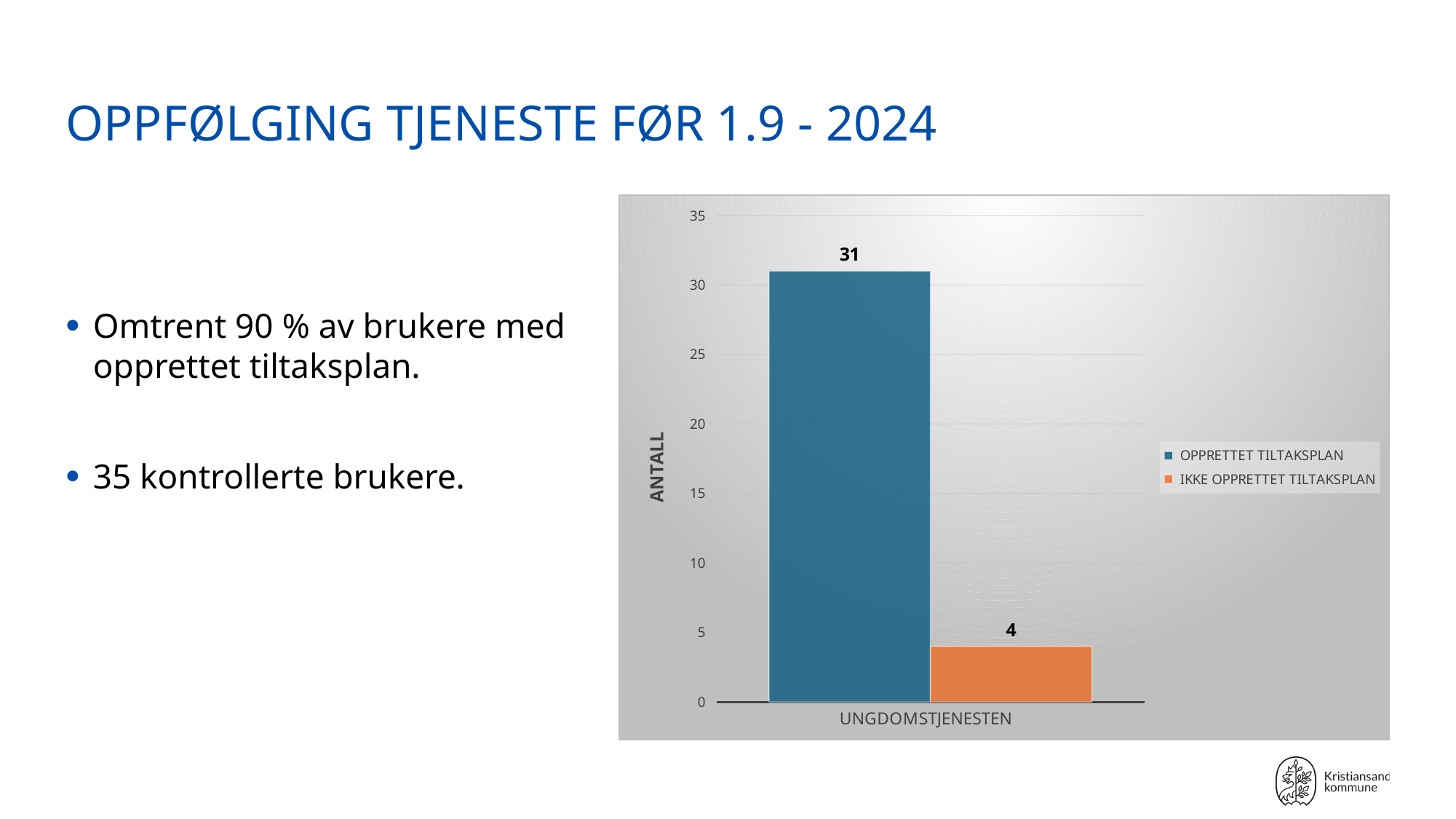
What kind of chart is shown on the slide? bar chart Is the value for OPPRETTET TILTAKSPLAN larger or smaller than the value for IKKE OPPRETTET TILTAKSPLAN? larger What is the label of the vertical axis of the chart? ANTALL Is the value for IKKE OPPRETTET TILTAKSPLAN greater or less than 5? less What is the difference between the values for OPPRETTET TILTAKSPLAN and IKKE OPPRETTET TILTAKSPLAN? 27 Is the value for OPPRETTET TILTAKSPLAN greater or less than 30? greater What is the value for IKKE OPPRETTET TILTAKSPLAN in the chart? 4 What is the value for OPPRETTET TILTAKSPLAN in the chart? 31 Which series has the higher value in the chart? OPPRETTET TILTAKSPLAN How many series does the legend list? 2 Which series has the lower value in the chart? IKKE OPPRETTET TILTAKSPLAN What is the category label on the x axis of the chart? UNGDOMSTJENESTEN